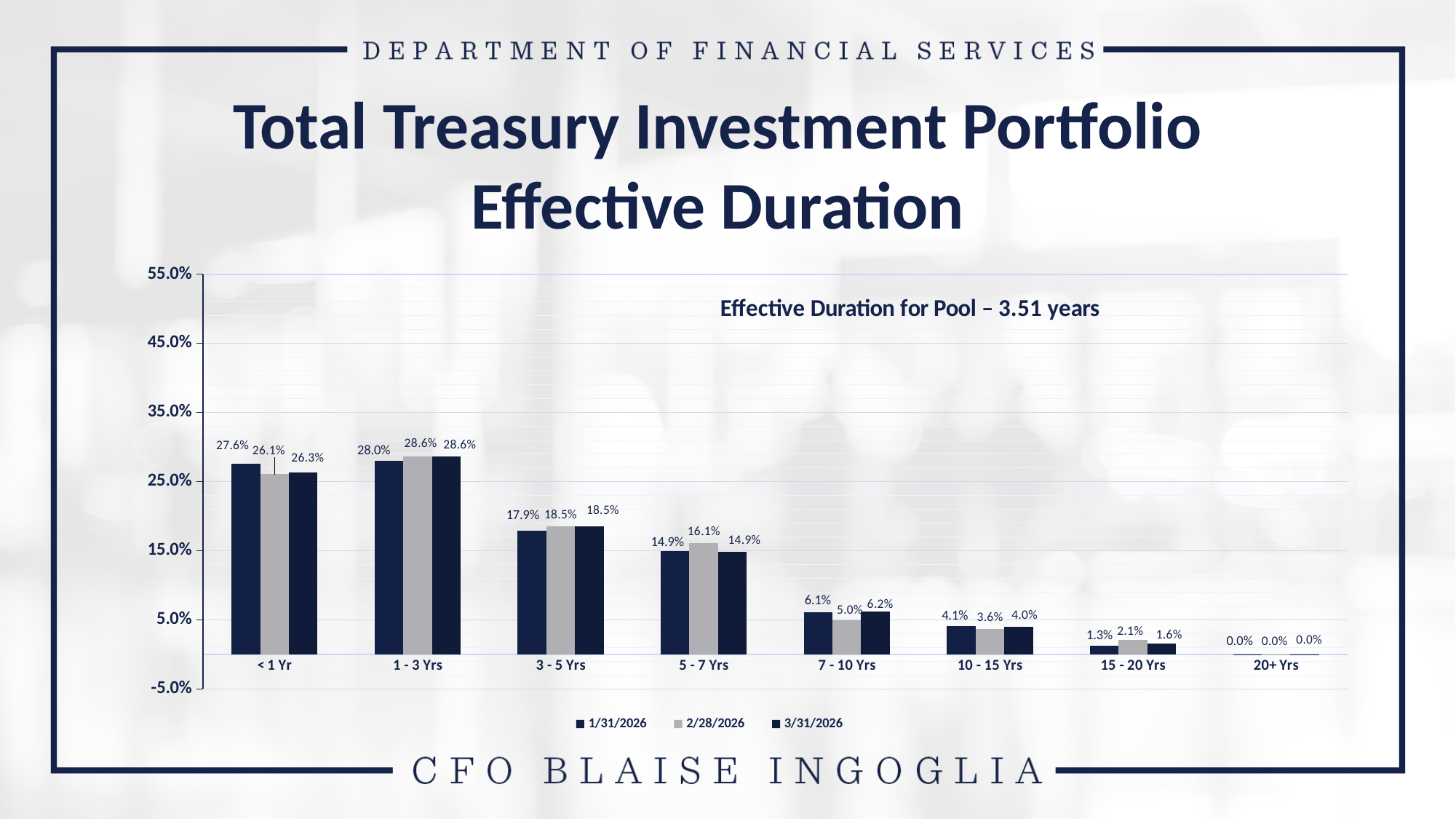
Which is larger for the 5 - 7 Yrs category: the 2/28/2026 value or the 3/31/2026 value? 2/28/2026 How many series does the legend list? 3 What is the difference between the 1/31/2026 and 2/28/2026 values for the < 1 Yr category? 1.5% What effective duration for the pool is stated on the chart? 3.51 years How many categories are shown on the x axis? 8 Is the 3/31/2026 value for 3 - 5 Yrs greater or less than 15.0%? greater What is the value for the 1 - 3 Yrs category in the 3/31/2026 series? 28.6% Which category has the lowest value in the 1/31/2026 series? 20+ Yrs Which category has the highest value in the 3/31/2026 series? 1 - 3 Yrs What kind of chart is shown on the slide? bar chart What is the value for the 7 - 10 Yrs category in the 2/28/2026 series? 5.0% What is the value for the < 1 Yr category in the 1/31/2026 series? 27.6%